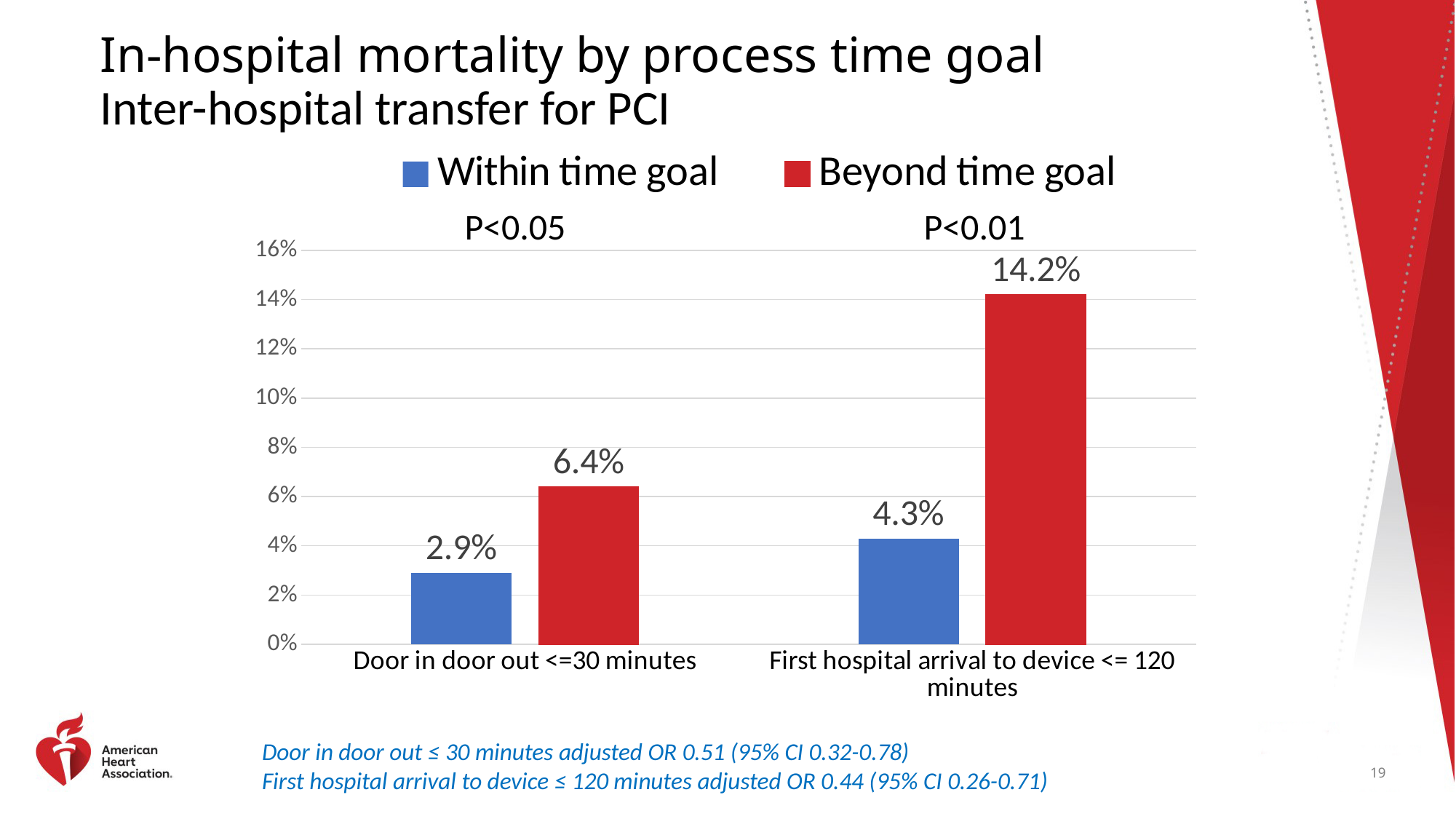
What is the in-hospital mortality for 'Beyond time goal' in the 'Door in door out <=30 minutes' category? 6.4% What is the in-hospital mortality for 'Within time goal' in the 'Door in door out <=30 minutes' category? 2.9% Which bar shows the lowest in-hospital mortality on the chart? Within time goal, Door in door out <=30 minutes What is the in-hospital mortality for 'Beyond time goal' in the 'First hospital arrival to device <= 120 minutes' category? 14.2% How many series does the legend list? 2 Which is larger: 'Within time goal' for 'First hospital arrival to device <= 120 minutes' or 'Within time goal' for 'Door in door out <=30 minutes'? First hospital arrival to device <= 120 minutes What is the difference between 'Beyond time goal' and 'Within time goal' in the 'Door in door out <=30 minutes' category? 3.5% How many categories are shown on the x axis? 2 What kind of chart is shown on the slide? Bar chart What is the in-hospital mortality for 'Within time goal' in the 'First hospital arrival to device <= 120 minutes' category? 4.3% Which bar shows the highest in-hospital mortality on the chart? Beyond time goal, First hospital arrival to device <= 120 minutes What is the difference between 'Beyond time goal' and 'Within time goal' in the 'First hospital arrival to device <= 120 minutes' category? 9.9%